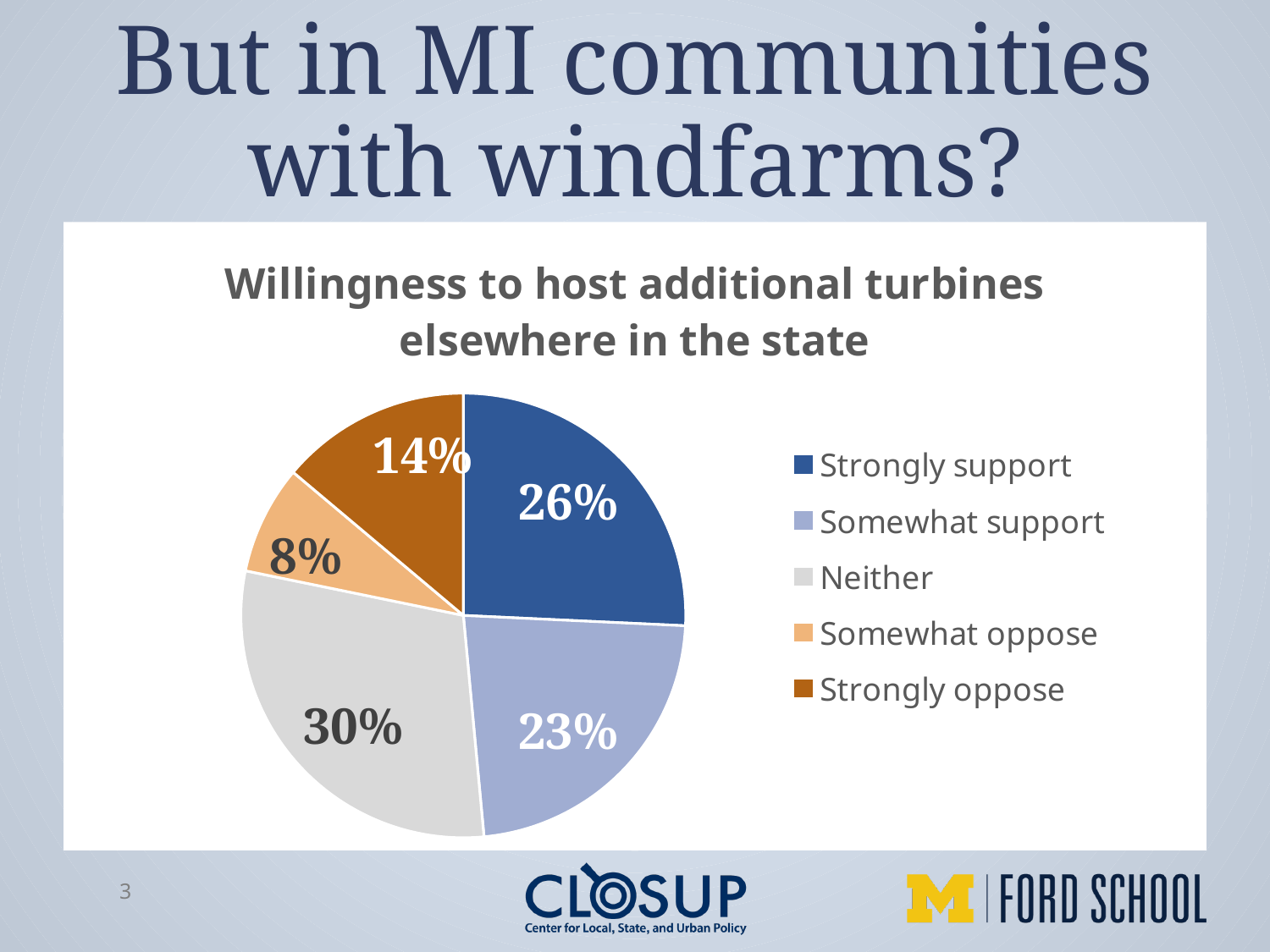
What percentage of respondents answered "Strongly oppose"? 14% What percentage of respondents answered "Neither"? 30% What colour is the "Strongly oppose" slice? dark orange/brown How many categories does the legend list? 5 Which response category has the largest share of the pie? Neither Which response category has the smallest share of the pie? Somewhat oppose Which is larger, the share for "Somewhat support" or the share for "Strongly oppose"? Somewhat support What kind of chart is shown on the slide? pie chart What is the title of the chart? Willingness to host additional turbines elsewhere in the state What percentage of respondents answered "Strongly support"? 26% What percentage of respondents answered "Somewhat oppose"? 8% What is the difference in percentage points between "Strongly support" and "Strongly oppose"? 12